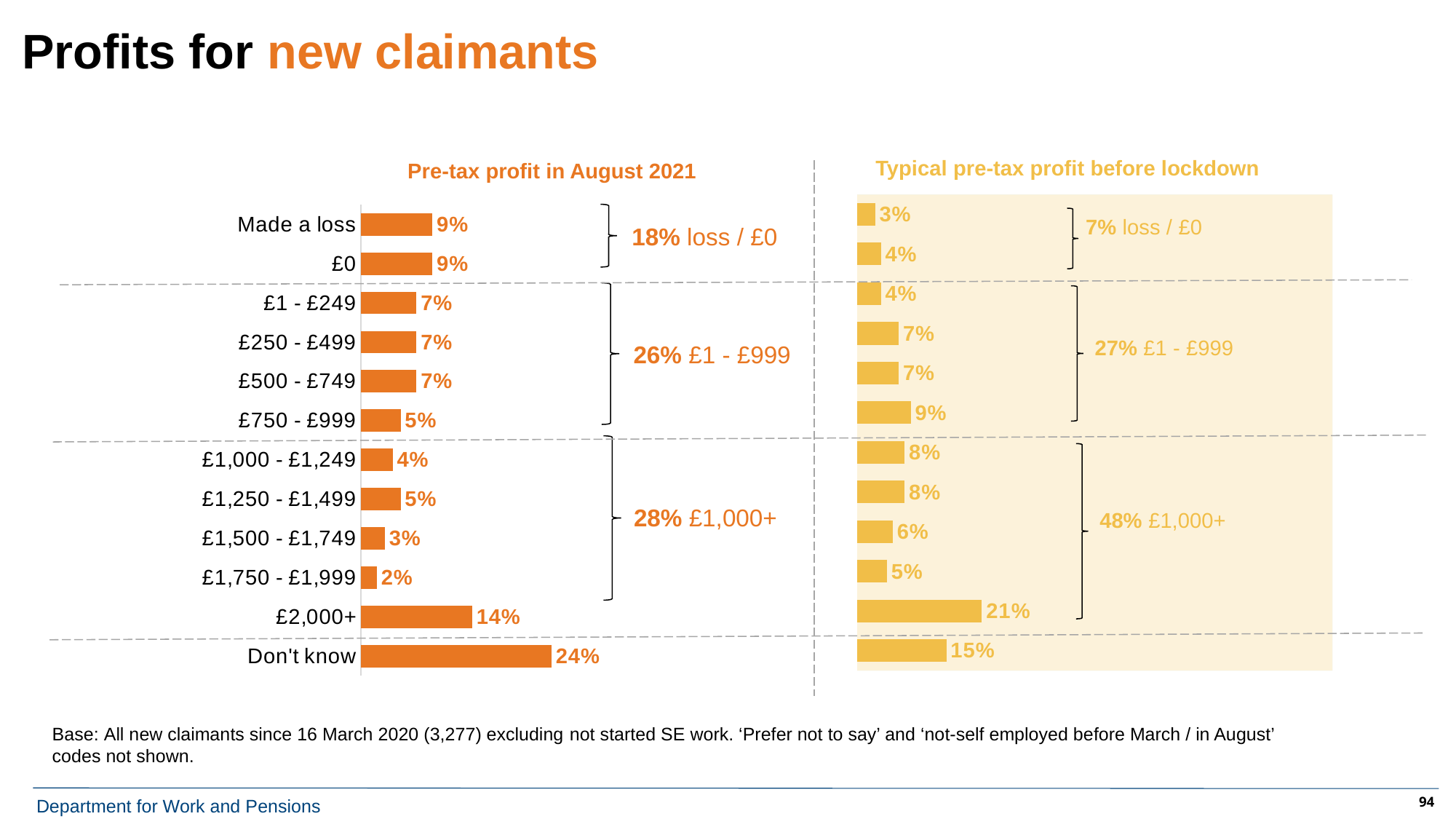
In the 'Pre-tax profit in August 2021' chart, which category has the highest value? Don't know In the 'Pre-tax profit in August 2021' chart, what is the value for '£1,750 - £1,999'? 2% In the 'Typical pre-tax profit before lockdown' chart, which category has the highest value? £2,000+ According to the annotation on the 'Typical pre-tax profit before lockdown' chart, what share of claimants had a typical profit of £1,000+? 48% Which is larger: the 'Don't know' value in the 'Pre-tax profit in August 2021' chart or in the 'Typical pre-tax profit before lockdown' chart? Pre-tax profit in August 2021 In the 'Typical pre-tax profit before lockdown' chart, what is the value for 'Made a loss'? 3% What is the difference between the '£2,000+' values in the 'Typical pre-tax profit before lockdown' chart and the 'Pre-tax profit in August 2021' chart? 7% In the 'Pre-tax profit in August 2021' chart, which category has the lowest value? £1,750 - £1,999 In the 'Pre-tax profit in August 2021' chart, what is the value for 'Don't know'? 24% In the 'Typical pre-tax profit before lockdown' chart, what is the value for '£2,000+'? 21% How many categories are shown in the 'Pre-tax profit in August 2021' chart? 12 What type of chart is the 'Pre-tax profit in August 2021' chart? Bar chart